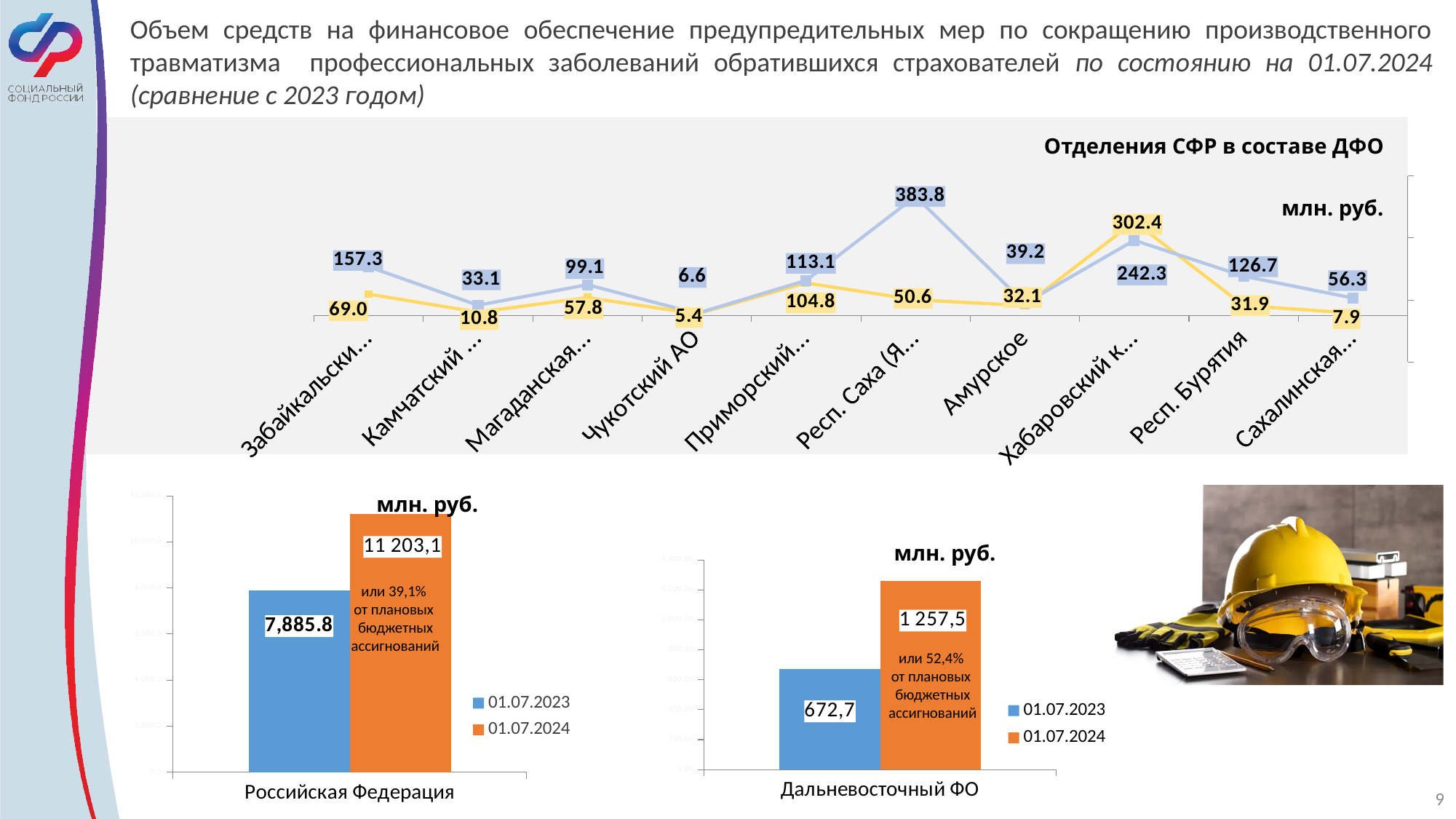
In the top chart 'Отделения СФР в составе ДФО', which category has the highest value on the yellow line? Хабаровский к... In the bottom-right chart 'Дальневосточный ФО', what is the value for 01.07.2024? 1 257,5 In the bottom-left chart 'Российская Федерация', what is the value for 01.07.2024? 11 203,1 In the bottom-right chart 'Дальневосточный ФО', how many series does the legend list? 2 In the top chart 'Отделения СФР в составе ДФО', which category has the lowest value on the yellow line? Чукотский АО In the top chart 'Отделения СФР в составе ДФО', what value is labelled on the blue line for Чукотский АО? 6.6 In the top chart 'Отделения СФР в составе ДФО', which category has the highest value on the blue line? Респ. Саха (Я... In the top chart 'Отделения СФР в составе ДФО', what value is labelled on the yellow line for Амурское? 32.1 In the bottom-left chart 'Российская Федерация', what is the value for 01.07.2023? 7,885.8 What kind of chart is the top chart 'Отделения СФР в составе ДФО'? line chart In the top chart 'Отделения СФР в составе ДФО', what is the difference between the blue and yellow values for Амурское? 7.1 In the top chart 'Отделения СФР в составе ДФО', how many categories are shown on the x axis? 10